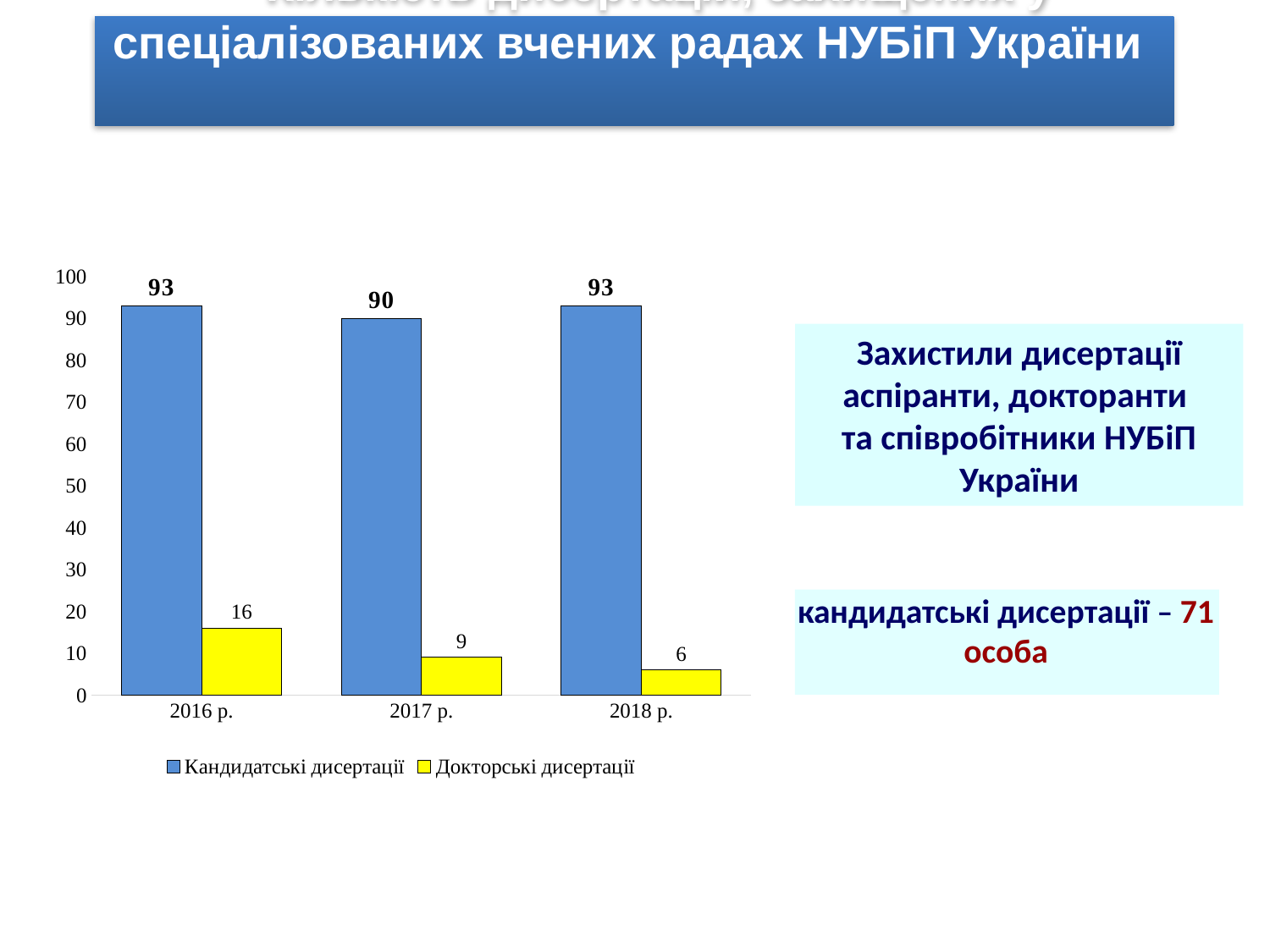
What is the value for Кандидатські дисертації in 2017 р.? 90 What kind of chart is shown on the slide? bar chart In which year is the value for Докторські дисертації the lowest? 2018 р. Which is larger: Кандидатські дисертації in 2016 р. or in 2017 р.? 2016 р. What is the difference between Кандидатські дисертації and Докторські дисертації in 2017 р.? 81 What is the difference between the Докторські дисертації values for 2016 р. and 2018 р.? 10 What is the value for Докторські дисертації in 2016 р.? 16 Is the value for Докторські дисертації in 2017 р. greater or less than 10? less How many years are shown on the x axis? 3 What is the value for Докторські дисертації in 2018 р.? 6 How many series does the legend list? 2 In which year is the value for Докторські дисертації the highest? 2016 р.